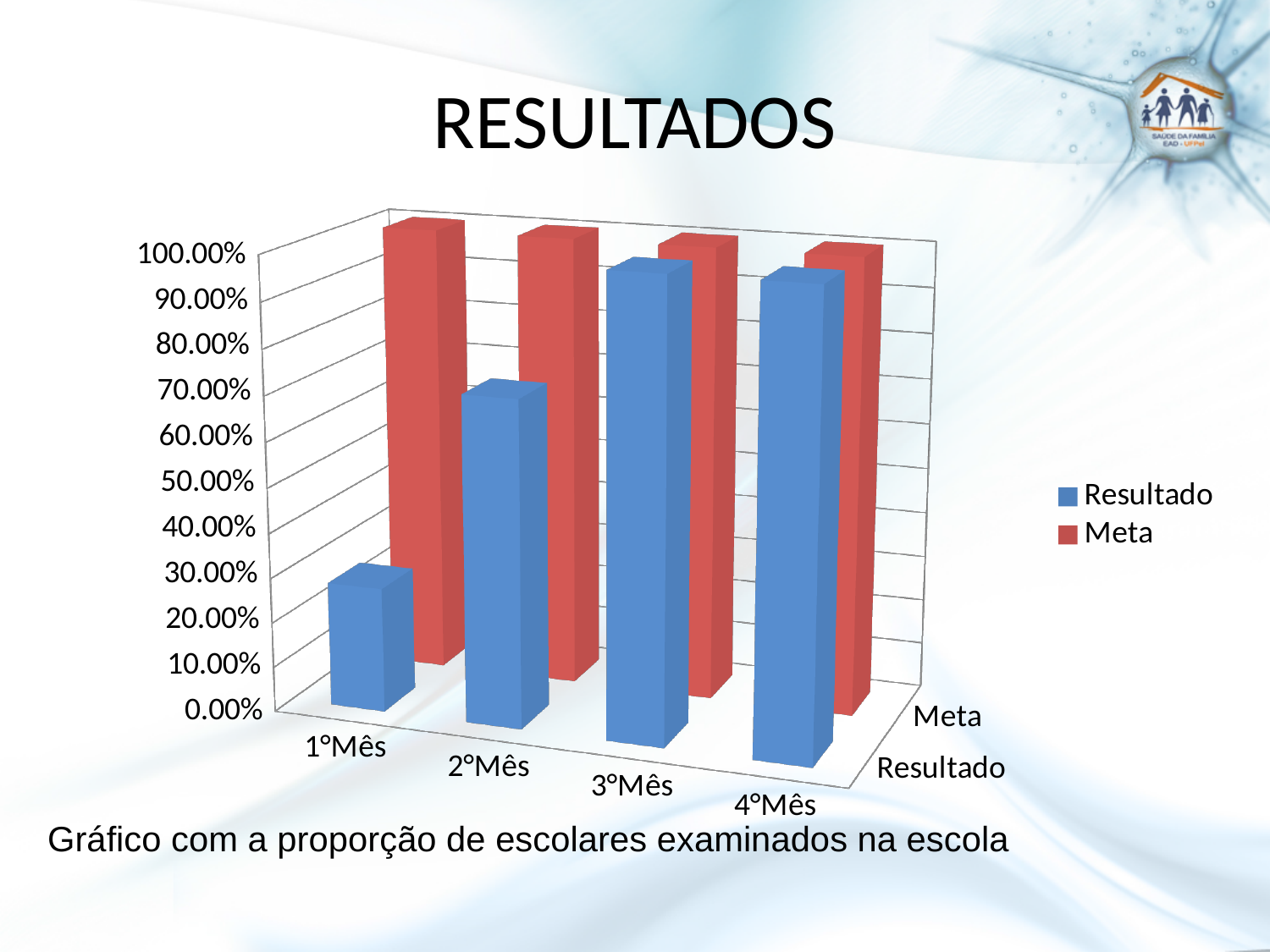
What kind of chart is shown on the slide? bar chart Is the Resultado value for 1°Mês greater or less than 40.00%? less Which month has the lowest Resultado value? 1°Mês Is the Resultado value for 3°Mês greater or less than 80.00%? greater Which month has the larger Resultado value, 1°Mês or 2°Mês? 2°Mês What are the two entries listed in the chart legend? Resultado and Meta Which is larger for 1°Mês, the Resultado value or the Meta value? Meta Is the Resultado value for 2°Mês greater or less than 80.00%? less How many month categories are shown on the x axis? 4 Do the Resultado values rise or fall from 1°Mês to 4°Mês? rise How many series does the legend list? 2